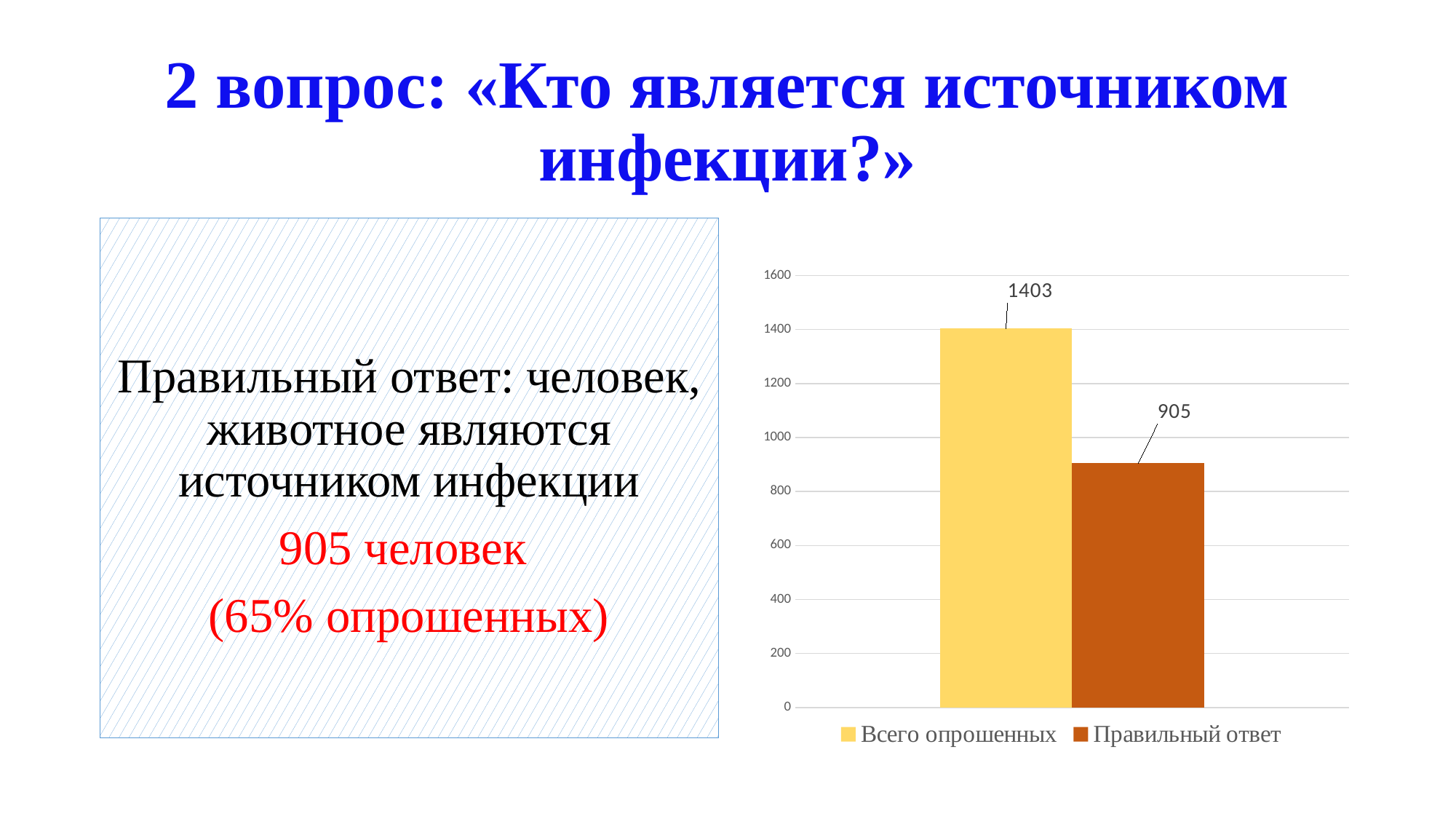
What is the difference between "Всего опрошенных" and "Правильный ответ"? 498 What colour is the bar for "Правильный ответ"? brown (dark orange) How many series does the legend list? 2 Which series has the lowest value? Правильный ответ What is the value for "Всего опрошенных"? 1403 What kind of chart is shown on the slide? bar chart Which is larger, "Всего опрошенных" or "Правильный ответ"? Всего опрошенных Which series has the highest value? Всего опрошенных How many bars are plotted in the chart? 2 Is the value for "Всего опрошенных" greater or less than 1200? greater Is the value for "Правильный ответ" greater or less than 1000? less What is the value for "Правильный ответ"? 905